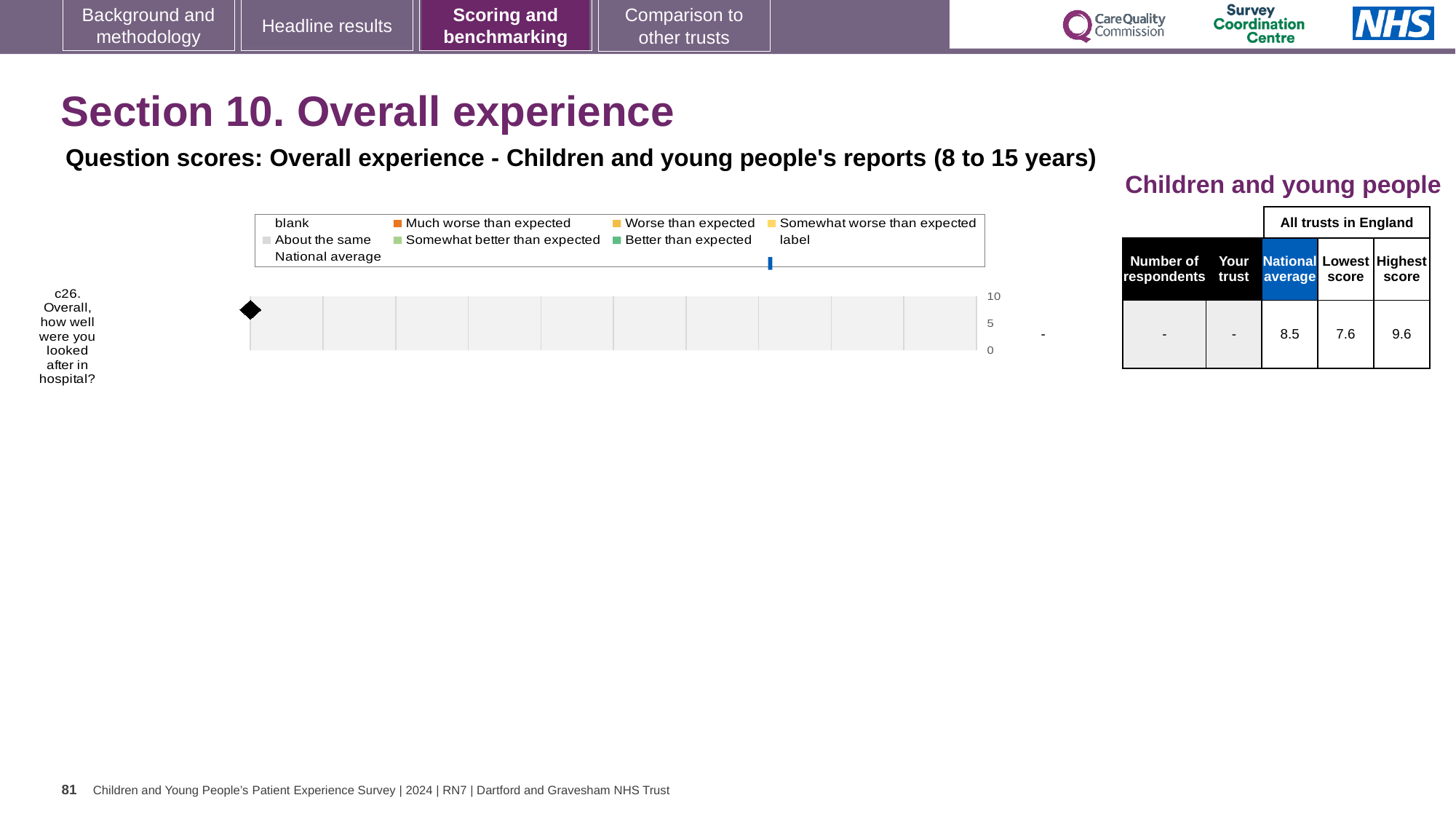
What kind of chart is shown on the slide? bar chart In the table beside the chart, what is the Lowest score for c26? 7.6 What is the highest tick value shown on the chart's axis? 10 How many question categories are plotted on the chart? 1 What question label is shown for the single category on the chart? c26. Overall, how well were you looked after in hospital? In the table beside the chart, what is the Highest score for c26? 9.6 In the table beside the chart, what is the National average score for c26? 8.5 In the table beside the chart, is the Highest score for c26 greater or less than 9? greater What value is printed for the trust's score on c26 next to the chart? - In the table beside the chart, which is larger for c26: the National average or the Lowest score? National average In the table beside the chart, what is the difference between the Highest score and the Lowest score for c26? 2.0